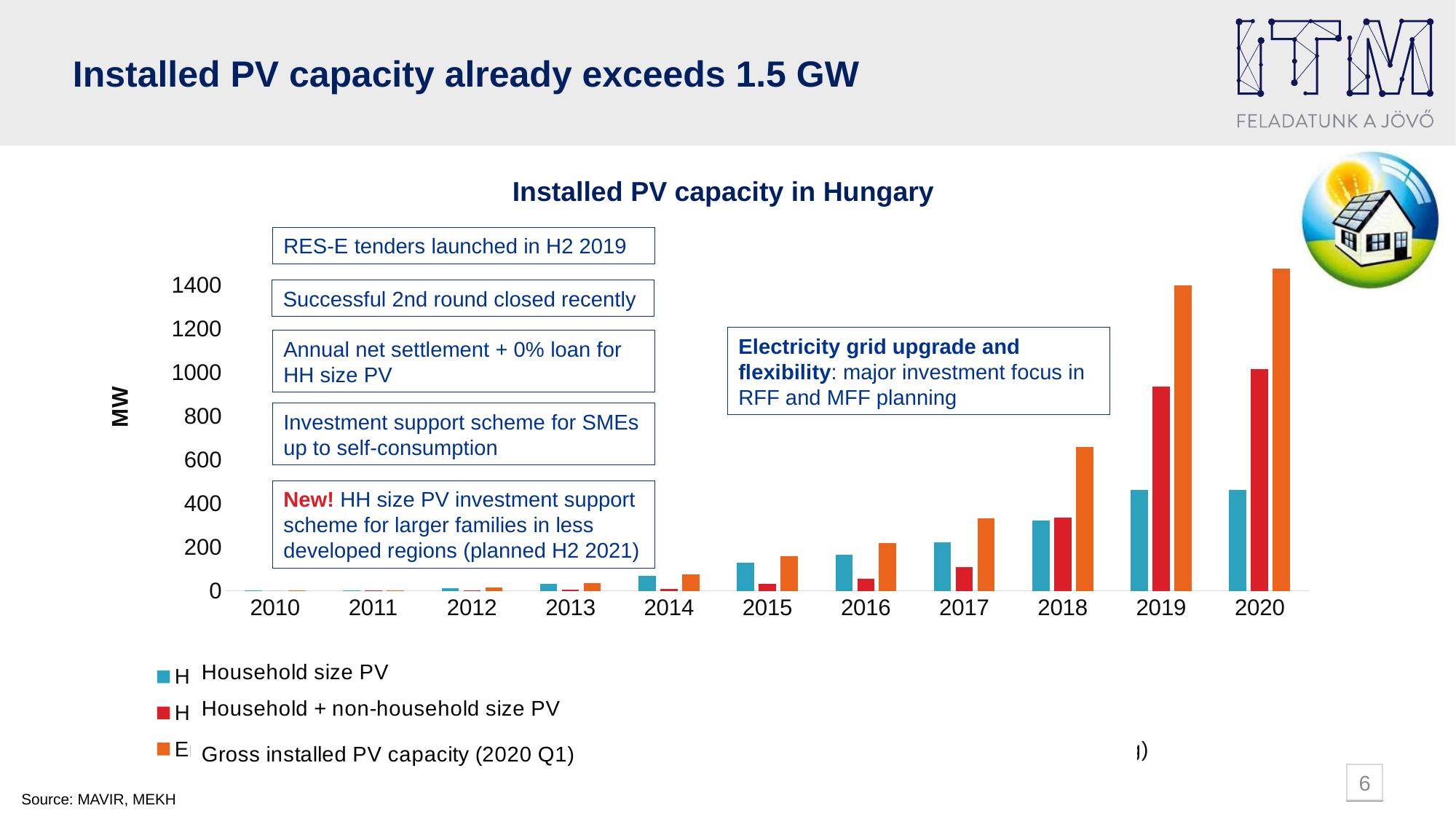
How many series does the chart's legend list? 3 What is the title of the chart? Installed PV capacity in Hungary What unit is shown on the y axis of the chart? MW Is the Gross installed PV capacity (2020 Q1) value for 2017 greater or less than 400? less Is the Household + non-household size PV value for 2019 greater or less than 800? greater In 2017, which is larger: Household size PV or Household + non-household size PV? Household size PV Is the Gross installed PV capacity (2020 Q1) value for 2019 greater or less than 1200? greater Does the Gross installed PV capacity (2020 Q1) rise or fall from 2010 to 2020? rise What type of chart is shown on the slide? bar chart How many years are shown on the x axis of the chart? 11 In which year is the Gross installed PV capacity (2020 Q1) highest? 2020